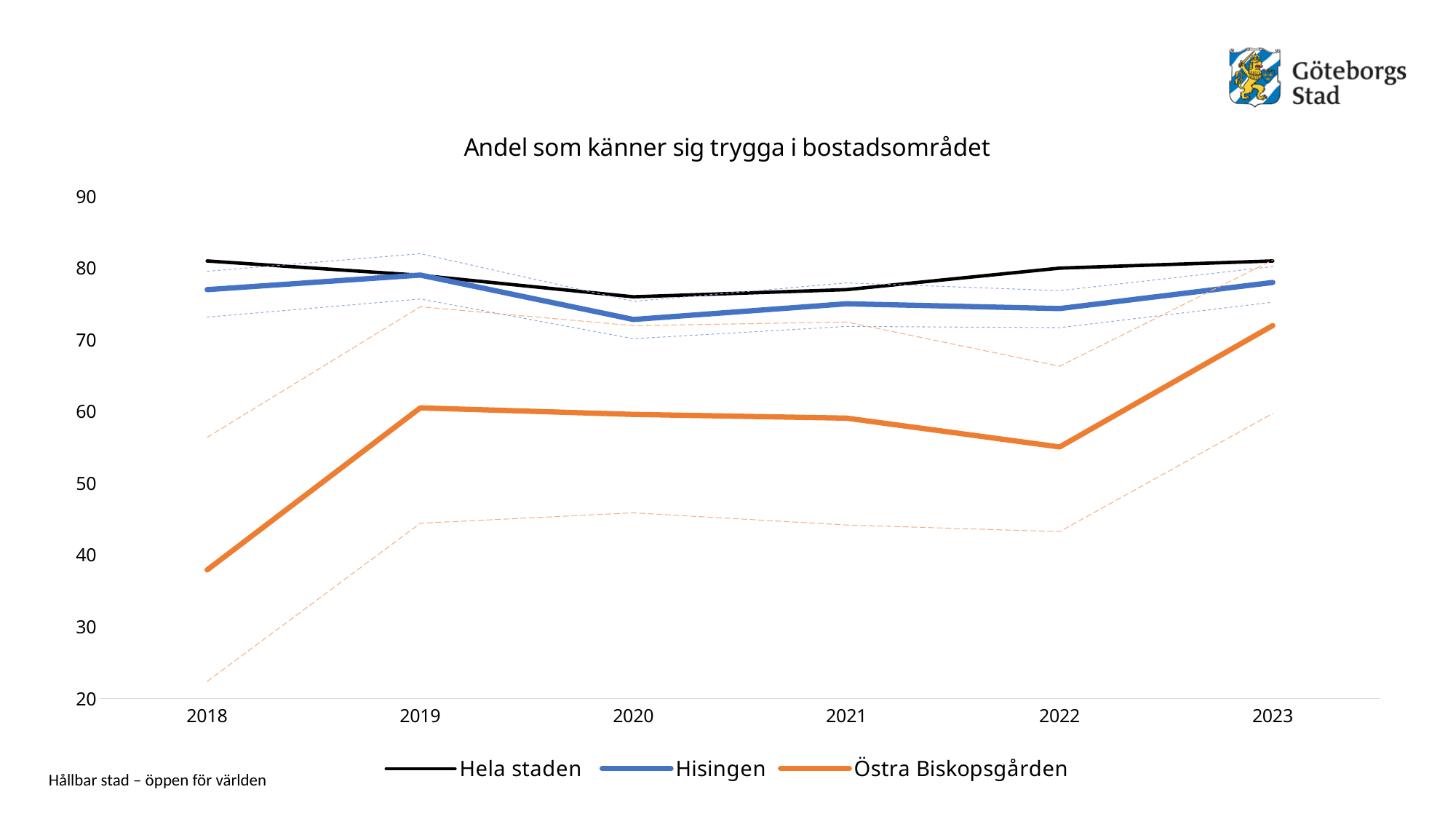
Is the value for Östra Biskopsgården in 2023 greater or less than 70? greater Is the value for Östra Biskopsgården in 2022 greater or less than 60? less Which is larger in 2018, the value for Hela staden or the value for Östra Biskopsgården? Hela staden Does the value for Östra Biskopsgården rise or fall from 2022 to 2023? rise In which year is the value for Östra Biskopsgården lowest? 2018 In which year is the value for Östra Biskopsgården highest? 2023 Which series is drawn with an orange line? Östra Biskopsgården What kind of chart is shown on the slide? Line chart How many series does the legend list? 3 What is the title of the chart? Andel som känner sig trygga i bostadsområdet How many years are shown on the x axis? 6 Is the value for Östra Biskopsgården in 2018 greater or less than 50? less